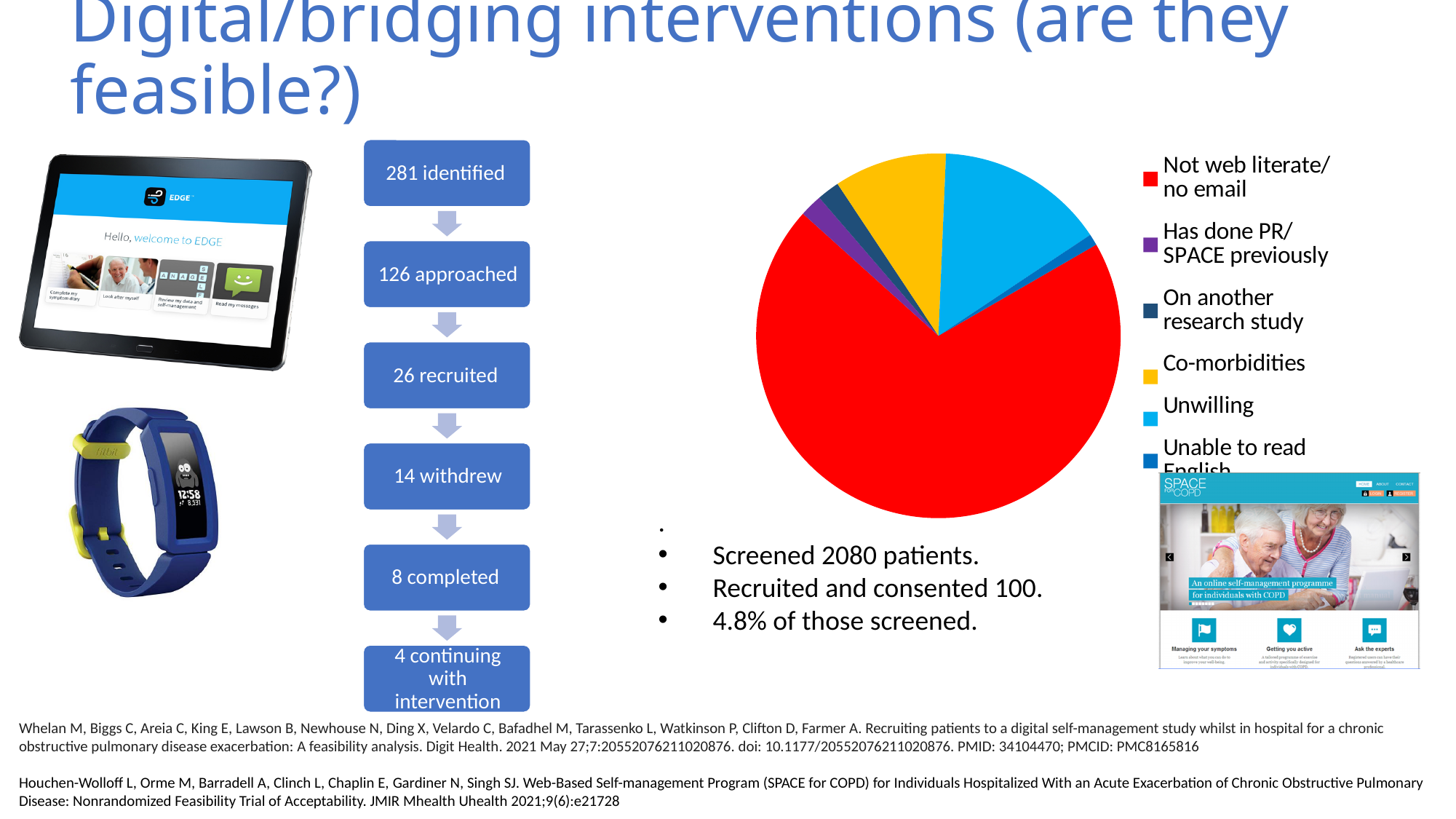
How many categories does the pie chart's legend list? 6 In the pie chart, which slice is larger: Unwilling or Unable to read English? Unwilling In the pie chart, which slice is larger: Co-morbidities or Has done PR/SPACE previously? Co-morbidities In the pie chart, which slice is larger: Unwilling or Co-morbidities? Unwilling What colour is the Not web literate/no email slice in the pie chart? red Which legend entry in the pie chart is shown in yellow? Co-morbidities Which category has the largest slice in the pie chart? Not web literate/no email What kind of chart is shown on the slide? pie chart